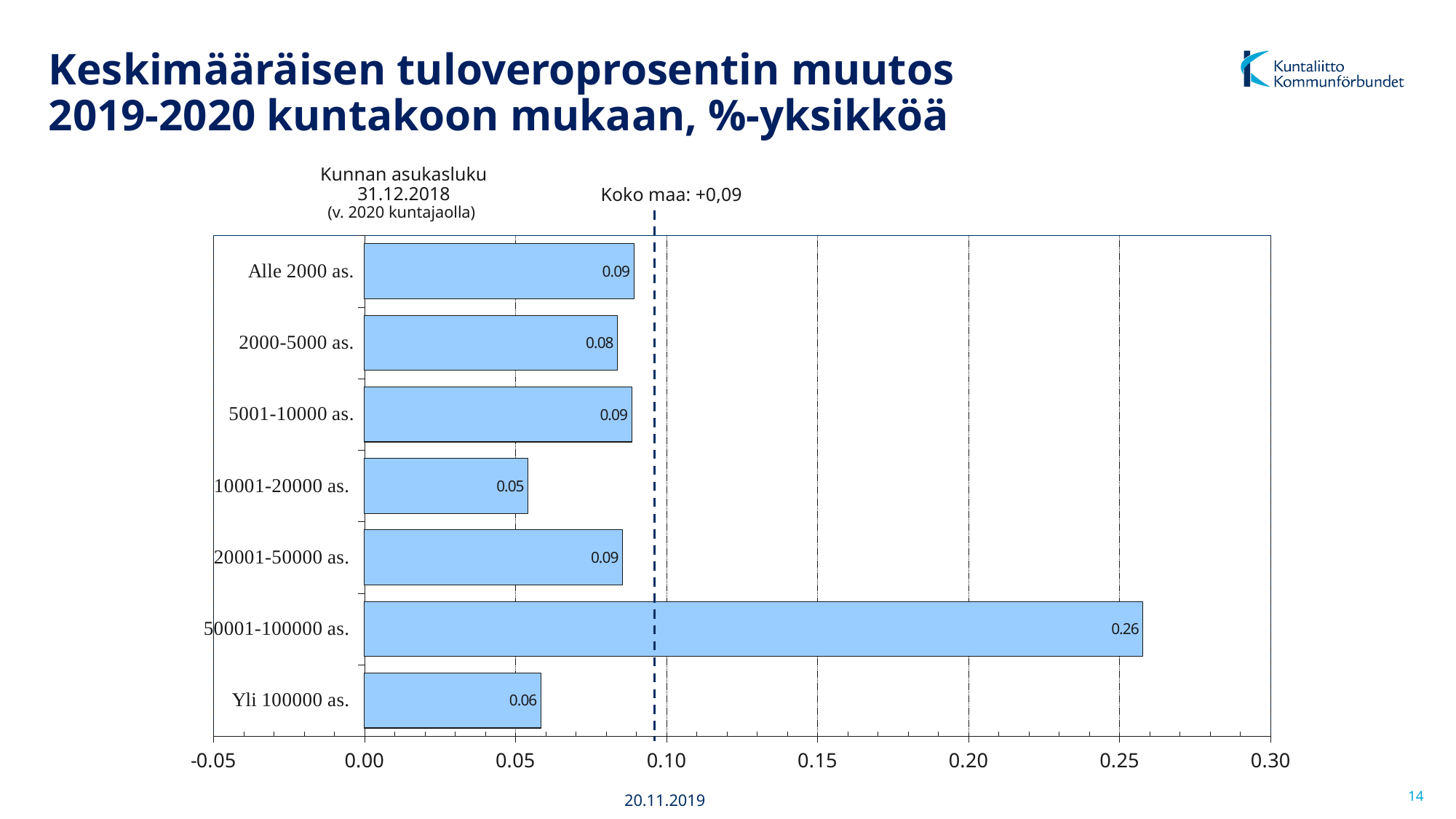
How many categories are shown in the chart? 7 What is the value for the 50001-100000 as. category? 0.26 What is the difference between the values for 50001-100000 as. and 10001-20000 as.? 0.21 Which category has the lowest value? 10001-20000 as. What is the value for the Yli 100000 as. category? 0.06 What is the value for the 10001-20000 as. category? 0.05 Which category has the highest value? 50001-100000 as. What is the value for the 2000-5000 as. category? 0.08 Which is larger, the value for 2000-5000 as. or the value for Yli 100000 as.? 2000-5000 as. What is the difference between the values for Alle 2000 as. and Yli 100000 as.? 0.03 What kind of chart is shown on the slide? bar chart Is the value for 50001-100000 as. greater or less than 0.20? greater